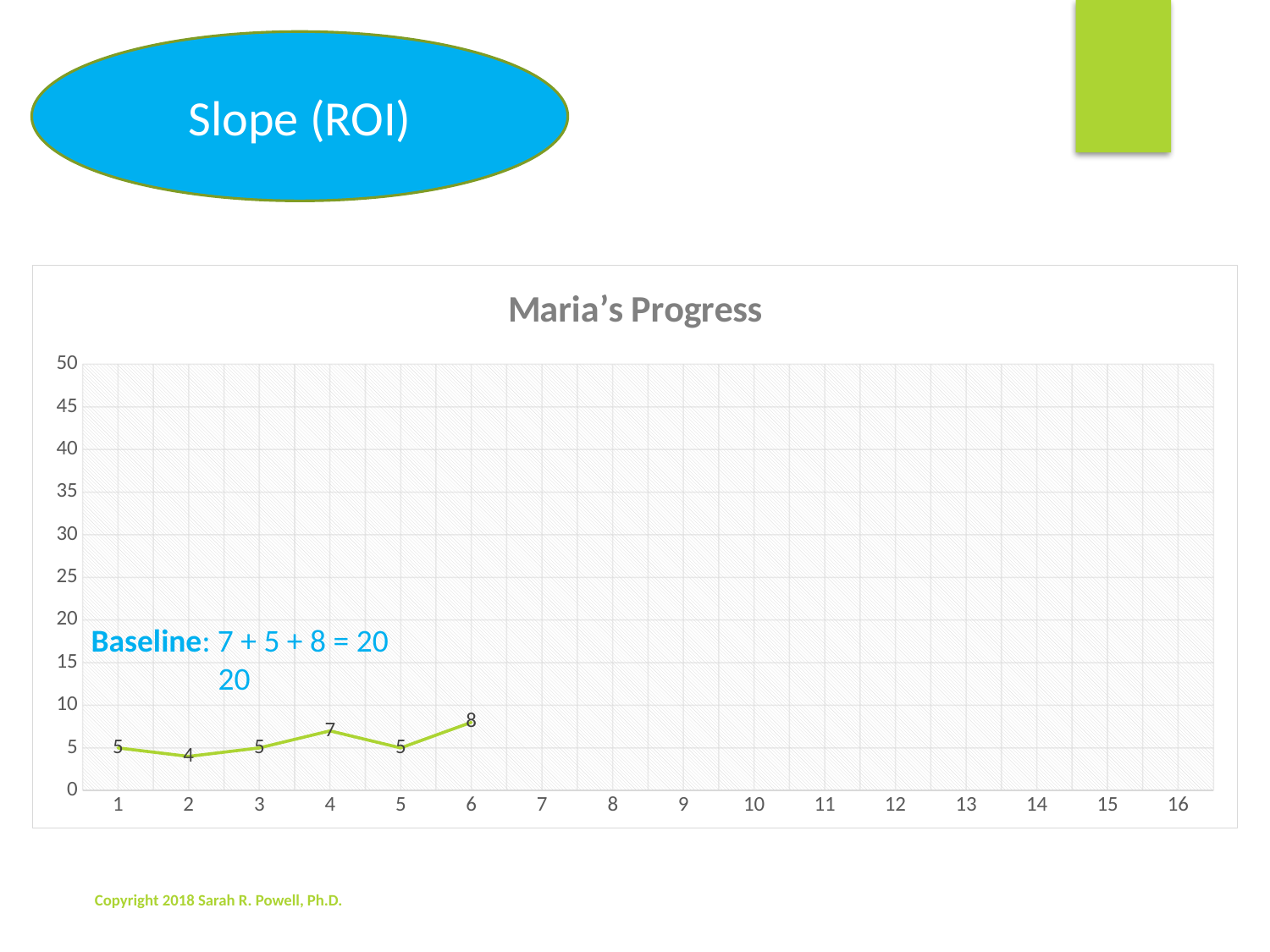
What is the value plotted at x = 6 in the Maria's Progress chart? 8 What is the value plotted at x = 4 in the Maria's Progress chart? 7 How many data points are plotted on the line in the Maria's Progress chart? 6 At which x value does the line in the Maria's Progress chart reach its lowest point? 2 What kind of chart is Maria's Progress? line chart At which x value does the line in the Maria's Progress chart reach its highest point? 6 Is the value at x = 6 in the Maria's Progress chart greater or less than 10? less In the Maria's Progress chart, is the value at x = 4 larger or smaller than the value at x = 5? larger What is the difference between the value at x = 6 and the value at x = 2 in the Maria's Progress chart? 4 What is the title of the chart on the slide? Maria's Progress What is the value plotted at x = 1 in the Maria's Progress chart? 5 What is the highest value shown on the y axis of the Maria's Progress chart? 50